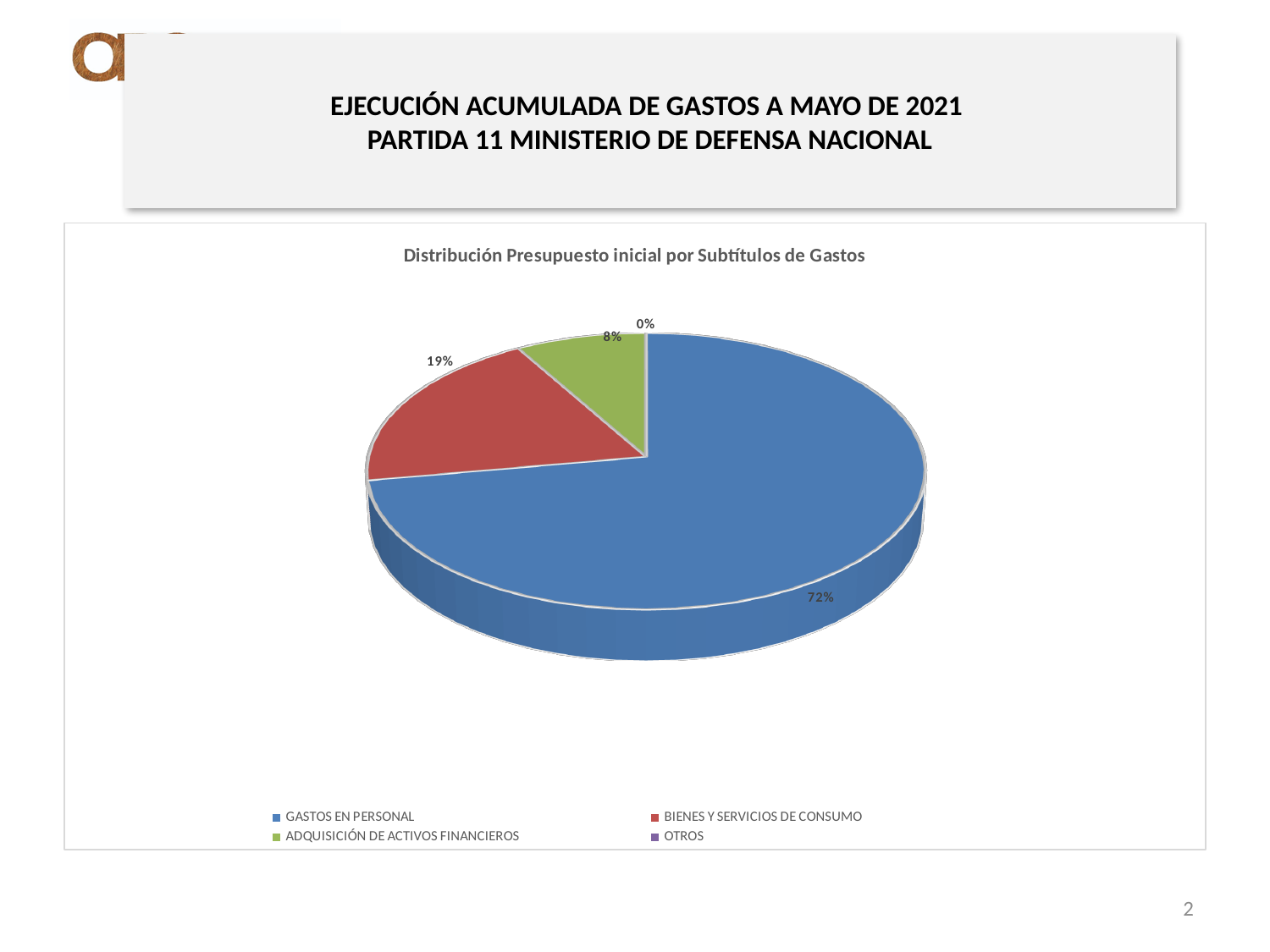
Which category has the largest share of the pie? GASTOS EN PERSONAL Which is larger, the share for BIENES Y SERVICIOS DE CONSUMO or the share for ADQUISICIÓN DE ACTIVOS FINANCIEROS? BIENES Y SERVICIOS DE CONSUMO What is the title of the chart? Distribución Presupuesto inicial por Subtítulos de Gastos What colour is the slice for GASTOS EN PERSONAL? Blue What share of the pie does ADQUISICIÓN DE ACTIVOS FINANCIEROS represent? 8% What share of the pie does OTROS represent? 0% What is the difference in percentage points between GASTOS EN PERSONAL and BIENES Y SERVICIOS DE CONSUMO? 53 What share of the pie does GASTOS EN PERSONAL represent? 72% What kind of chart is shown on the slide? Pie chart How many categories does the legend list? 4 Which category has the smallest share of the pie? OTROS